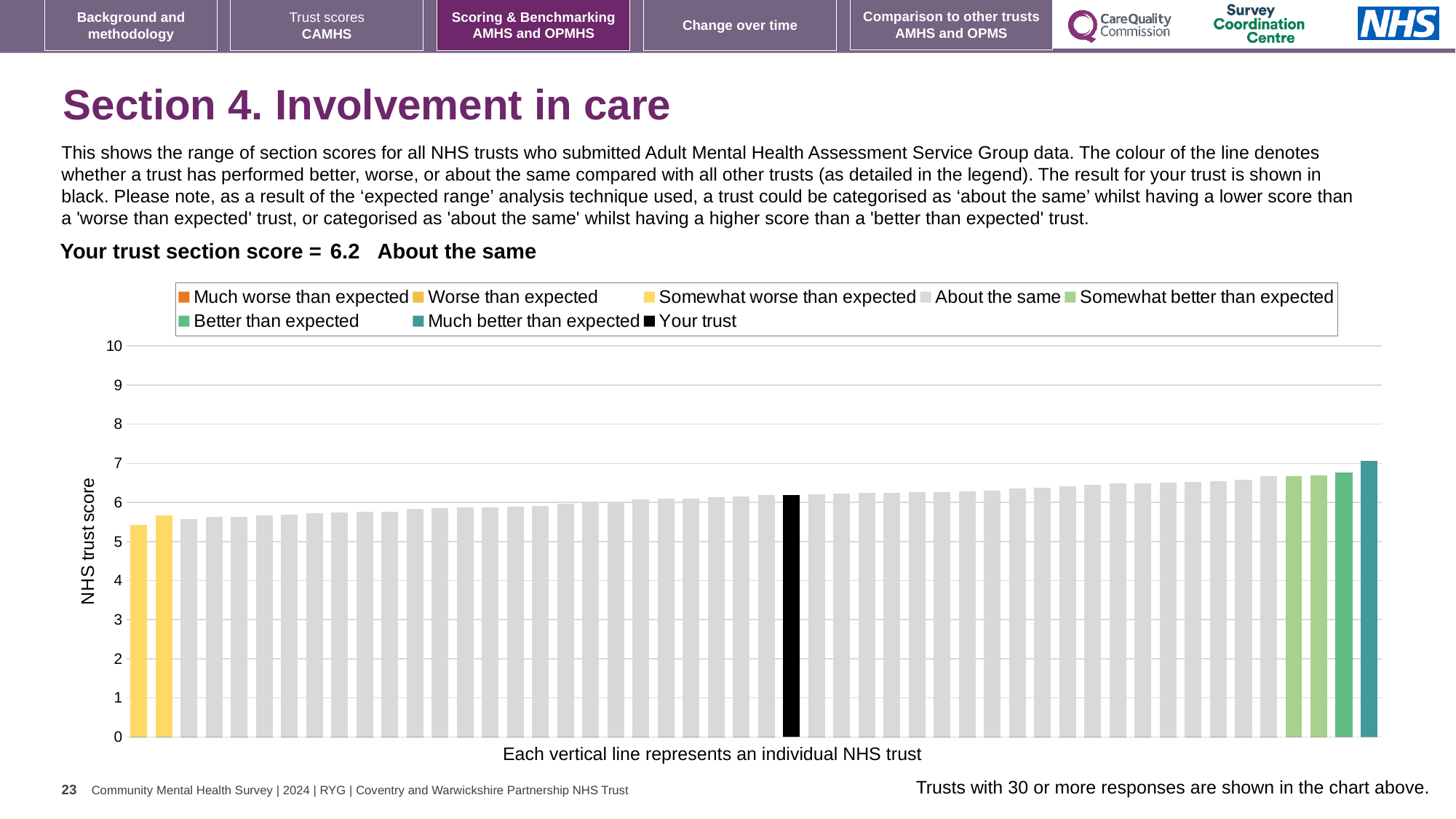
Is the value for your trust greater or less than 6? greater How many bars are in the 'Worse than expected' category? 0 What is the label on the vertical axis? NHS trust score How many entries does the chart legend list? 8 Is the value of the lowest bar greater or less than 6? less What kind of chart is shown on the slide? Bar chart What colour is the bar representing your trust? Black Is the value of the highest bar greater or less than 6? greater Which legend category does the lowest bar belong to? Somewhat worse than expected Do the bar values rise or fall from left to right along the x axis? Rise What is your trust's section score for Involvement in care? 6.2 Which legend category does the highest bar belong to? Much better than expected